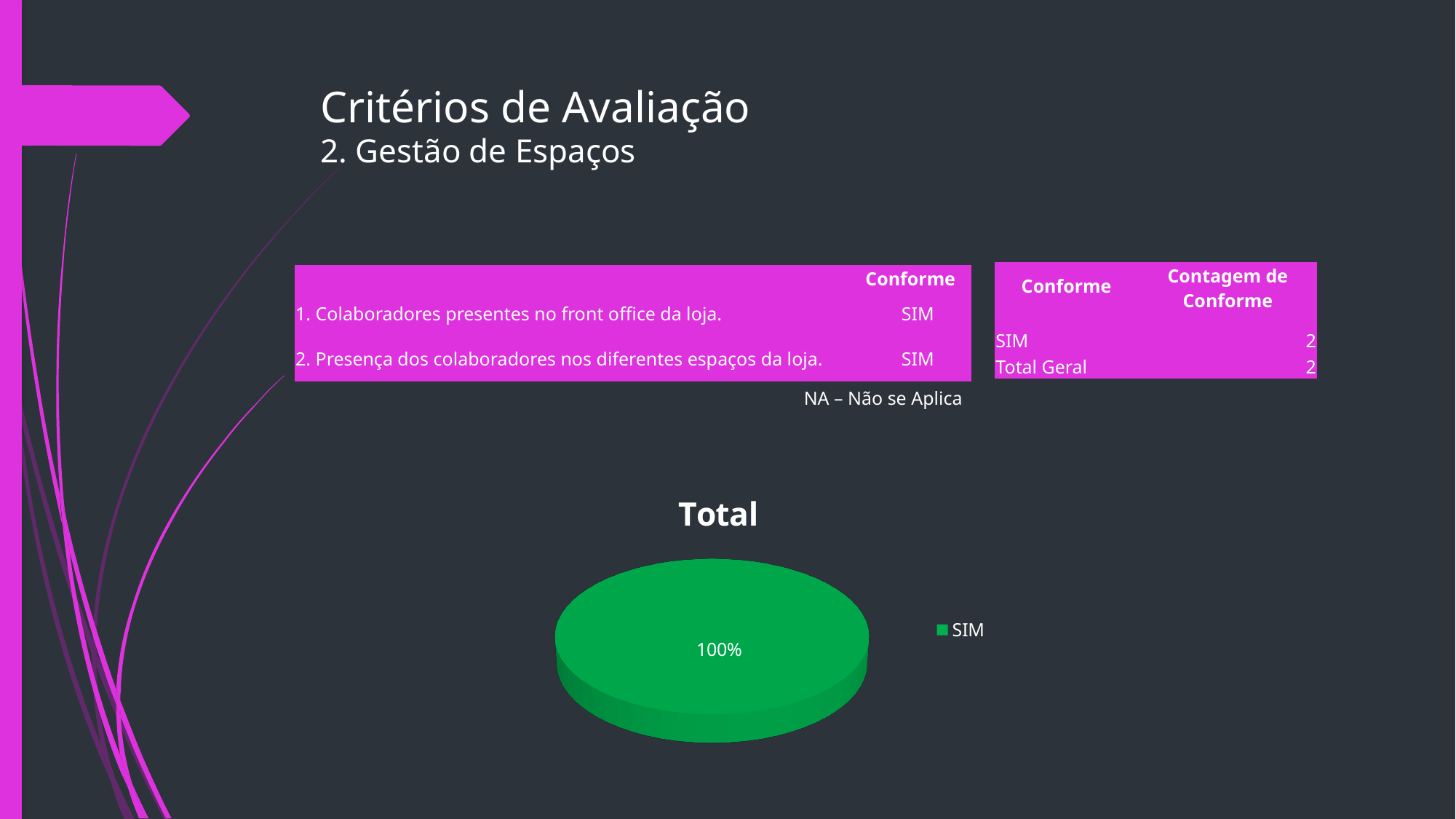
What is the title of the chart? Total How many slices does the pie chart have? 1 Which category is shown in the chart legend? SIM What kind of chart is shown on the slide? pie chart What is the data label printed on the pie slice? 100% What share of the pie does the SIM slice represent? 100% How many entries does the chart legend list? 1